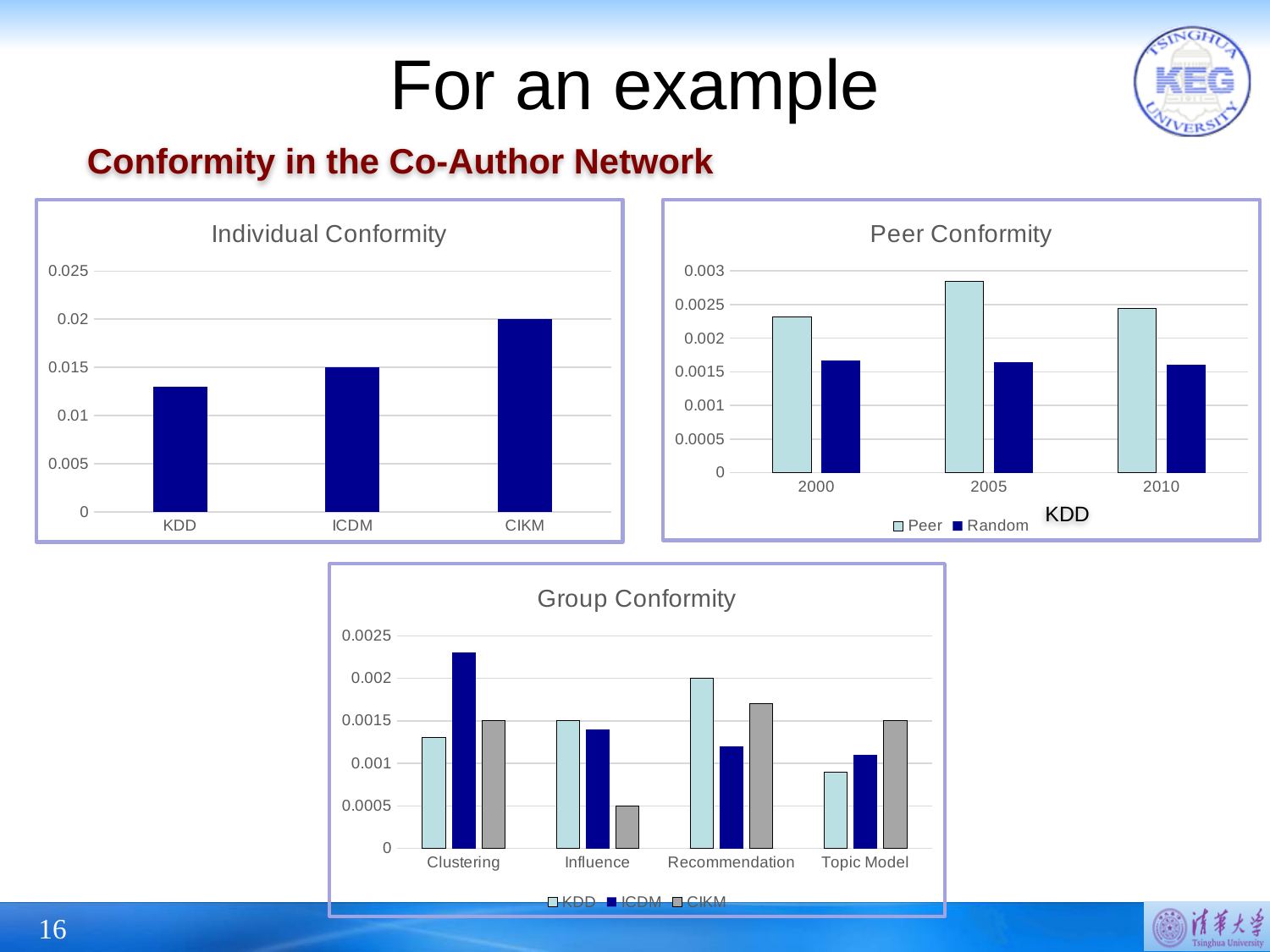
How many categories are shown on the x axis of the Individual Conformity chart? 3 In the Peer Conformity chart, which year has the highest Peer value? 2005 In the Group Conformity chart, which category has the highest ICDM value? Clustering In the Individual Conformity chart, which category has the lowest value? KDD How many series does the legend of the Group Conformity chart list? 3 In the Individual Conformity chart, which category has the highest value? CIKM How many series does the legend of the Peer Conformity chart list? 2 What type of chart is the Individual Conformity chart? bar chart In the Individual Conformity chart, is the value for KDD greater or less than 0.015? less In the Peer Conformity chart, is the Random value for 2010 greater or less than 0.002? less In the Group Conformity chart, is the CIKM value for Influence greater or less than 0.001? less